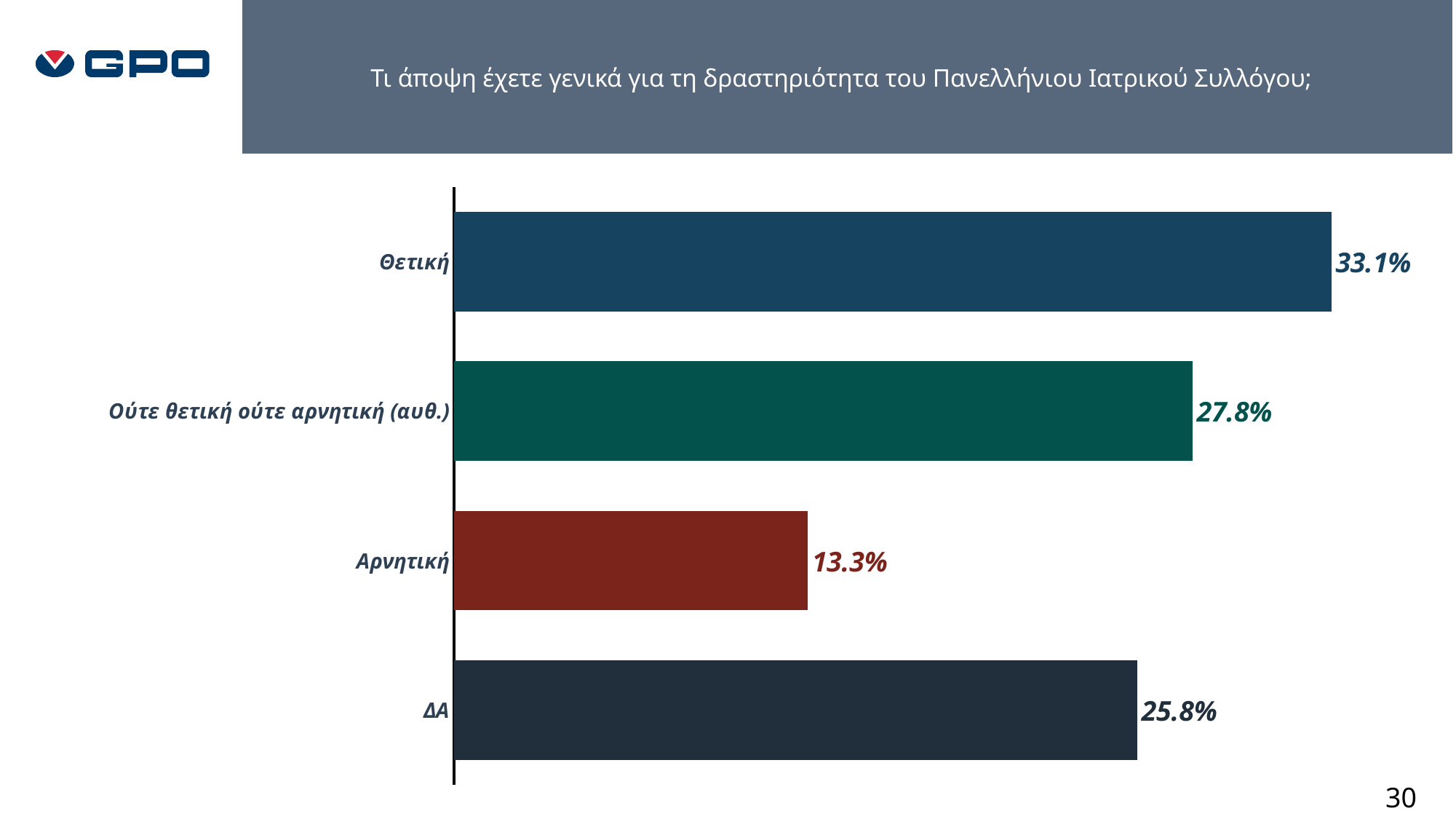
What is the difference between the values for Θετική and Αρνητική? 19.8% What is the difference between the values for Ούτε θετική ούτε αρνητική (αυθ.) and ΔΑ? 2.0% How many categories are shown in the chart? 4 What colour is the bar for Αρνητική? dark red Which category has the highest value? Θετική Which category has the lowest value? Αρνητική Which is larger, the value for ΔΑ or the value for Αρνητική? ΔΑ What is the value for ΔΑ? 25.8% What kind of chart is shown on the slide? bar chart What is the value for Αρνητική? 13.3% What is the value for Ούτε θετική ούτε αρνητική (αυθ.)? 27.8% What is the value for Θετική? 33.1%